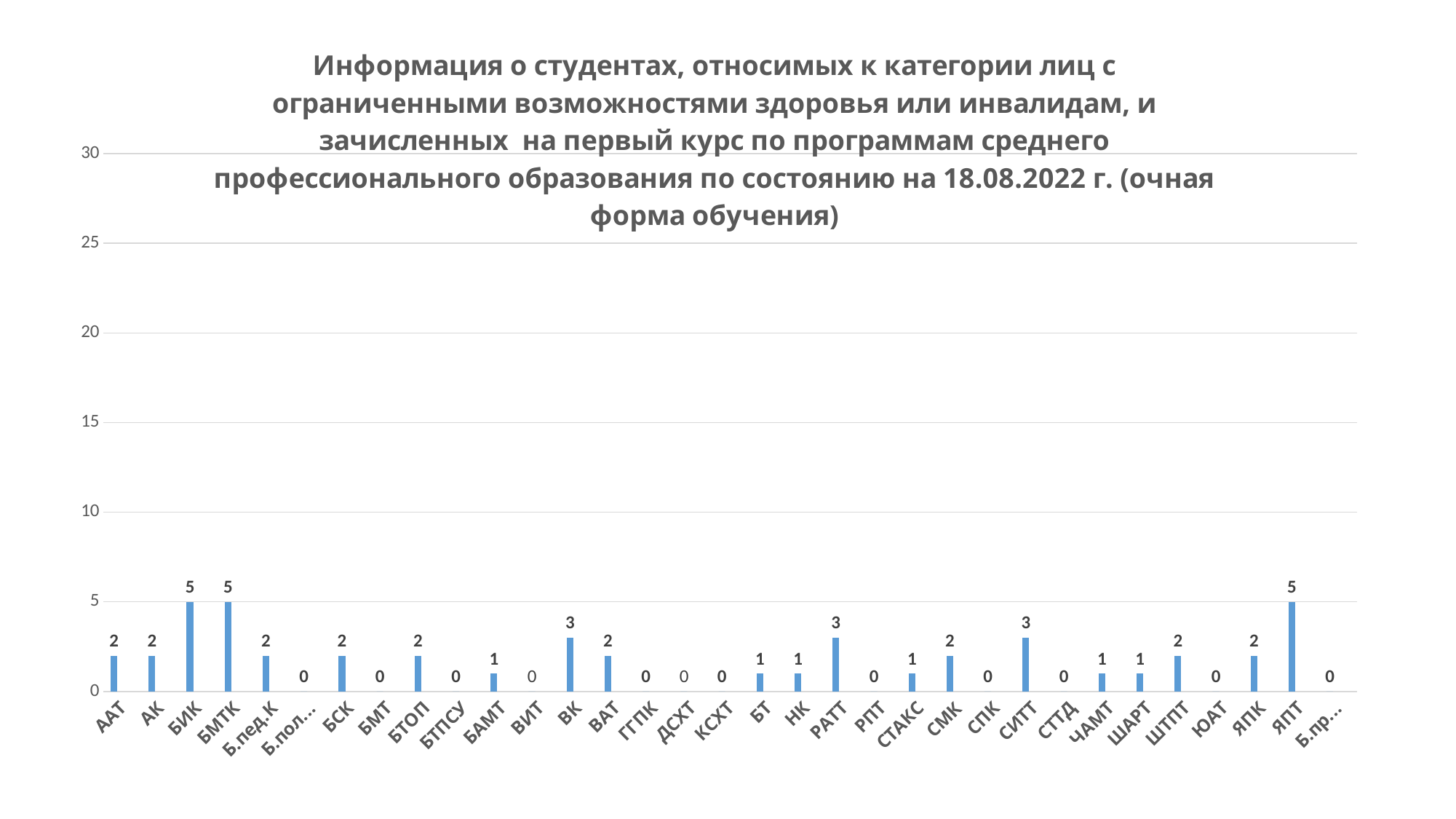
Which is larger, the value for СИТТ or the value for СМК? СИТТ What kind of chart is shown on the slide? bar chart What is the value for БАМТ? 1 What is the value for ЯПТ? 5 What is the value for СМК? 2 As of what date does the chart title say the data is reported? 18.08.2022 How many categories are shown on the x axis? 33 Which categories share the highest value in the chart? БИК, БМТК, ЯПТ Is the value for ЯПТ greater or less than 10? less What is the highest value shown in the chart? 5 What is the difference between the values for БИК and ВК? 2 What is the value for ВК? 3